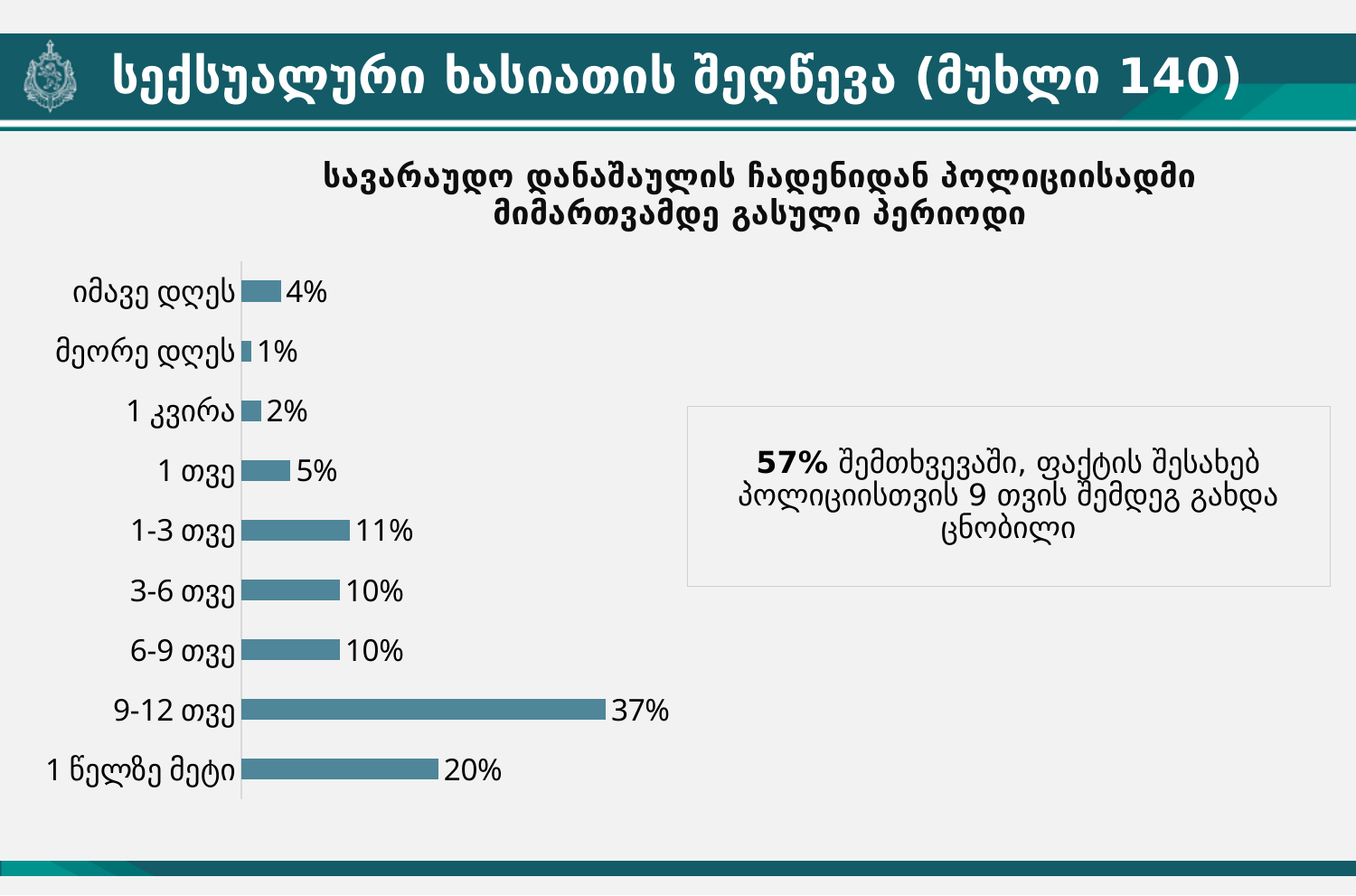
What is the value for the category "იმავე დღეს"? 4% What is the value for the category "1-3 თვე"? 11% What is the value for the category "1 წელზე მეტი"? 20% How many categories are shown in the chart? 9 What is the difference between the values for "1 თვე" and "1 კვირა"? 3% What is the value for the category "9-12 თვე"? 37% What kind of chart is shown on the slide? Bar chart Which is larger, the value for "1-3 თვე" or the value for "3-6 თვე"? 1-3 თვე Which category has the lowest value? მეორე დღეს Which category has the highest value? 9-12 თვე What is the difference between the values for "9-12 თვე" and "1 წელზე მეტი"? 17% What percentage is highlighted in bold in the text box to the right of the chart? 57%